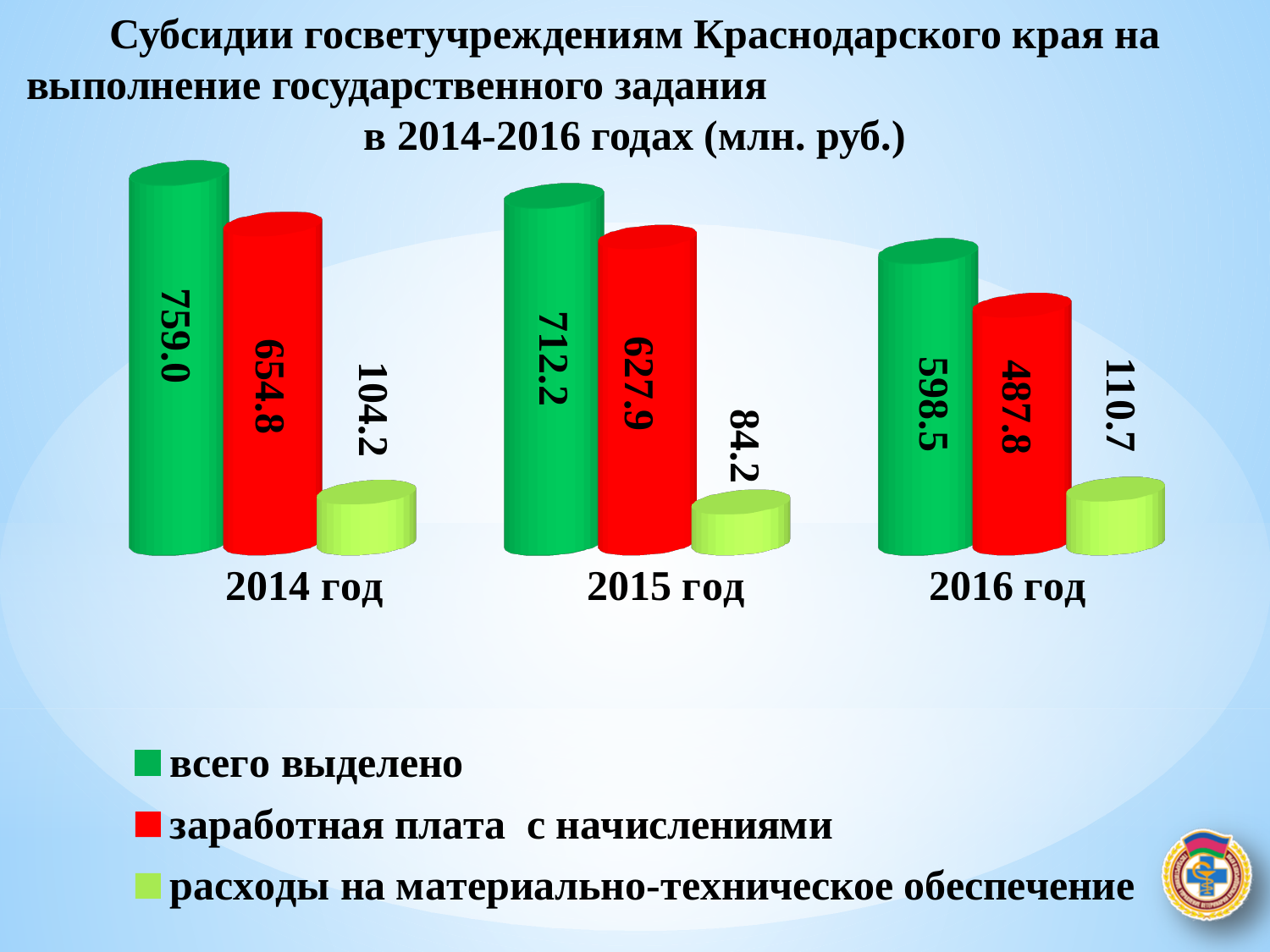
Does "всего выделено" rise or fall from 2014 год to 2016 год? fall What is the difference between "всего выделено" and "заработная плата с начислениями" in 2016 год? 110.7 What is the difference between "всего выделено" in 2014 год and 2016 год? 160.5 What is the value of "всего выделено" for 2014 год? 759.0 How many series does the legend list? 3 What kind of chart is shown on the slide? bar chart What is the value of "расходы на материально-техническое обеспечение" for 2016 год? 110.7 In which year is "расходы на материально-техническое обеспечение" the lowest? 2015 год Which is larger: "заработная плата с начислениями" in 2014 год or in 2015 год? 2014 год In which year is "всего выделено" the highest? 2014 год What is the value of "заработная плата с начислениями" for 2015 год? 627.9 How many years are shown on the x axis? 3